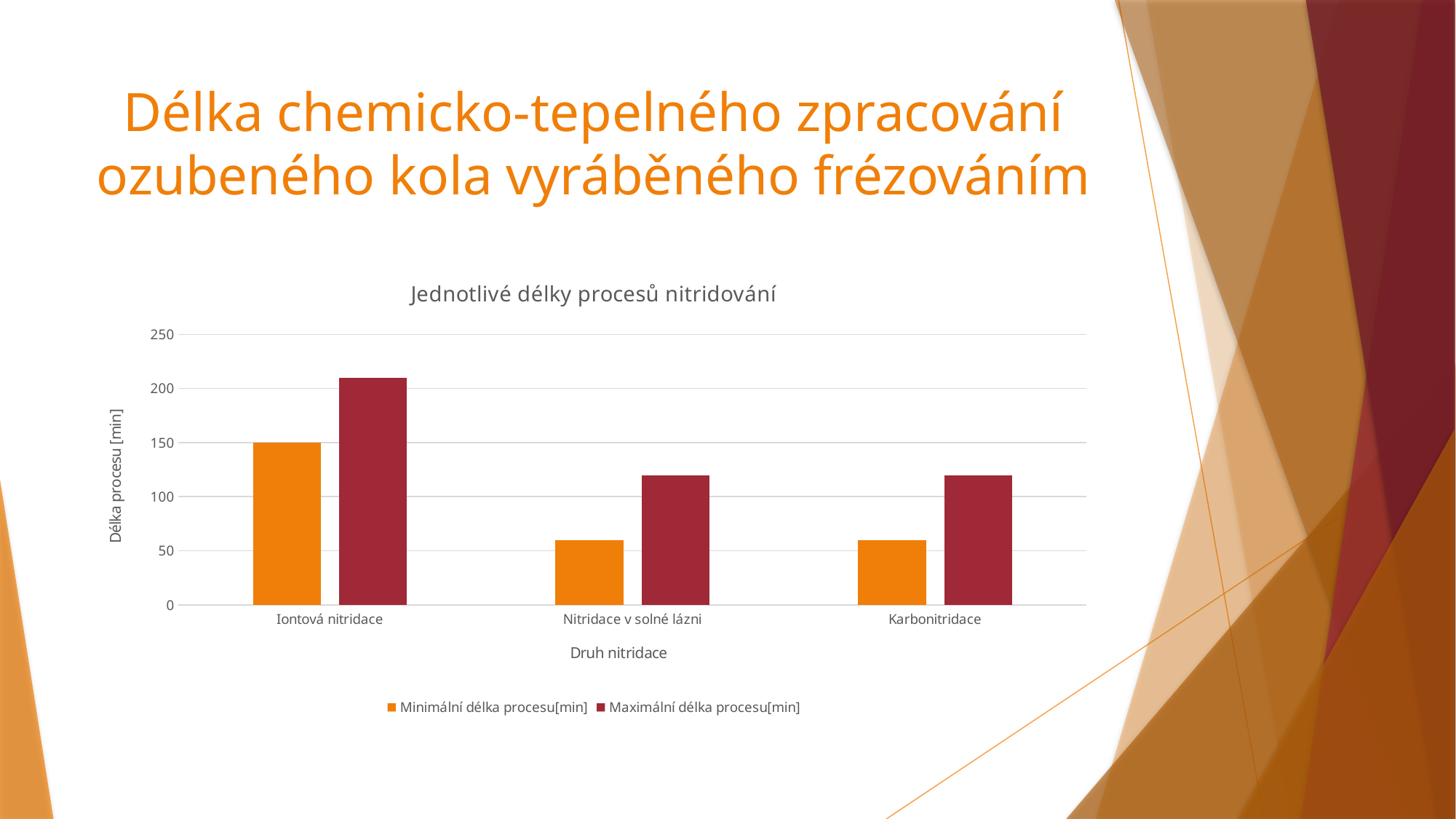
How many series does the legend list? 2 What is the label of the y axis? Délka procesu [min] Is the Maximální délka procesu[min] value for Karbonitridace greater or less than 100? greater How many categories are shown on the x axis? 3 What is the title of the chart? Jednotlivé délky procesů nitridování Is the Minimální délka procesu[min] value for Nitridace v solné lázni greater or less than 100? less Is the Maximální délka procesu[min] value for Iontová nitridace greater or less than 200? greater What kind of chart is shown on the slide? bar chart Which category has the highest Minimální délka procesu[min] value? Iontová nitridace Which category has the highest Maximální délka procesu[min] value? Iontová nitridace Which is larger: the Minimální délka procesu[min] value for Iontová nitridace or for Karbonitridace? Iontová nitridace What is the Minimální délka procesu[min] value for Iontová nitridace? 150